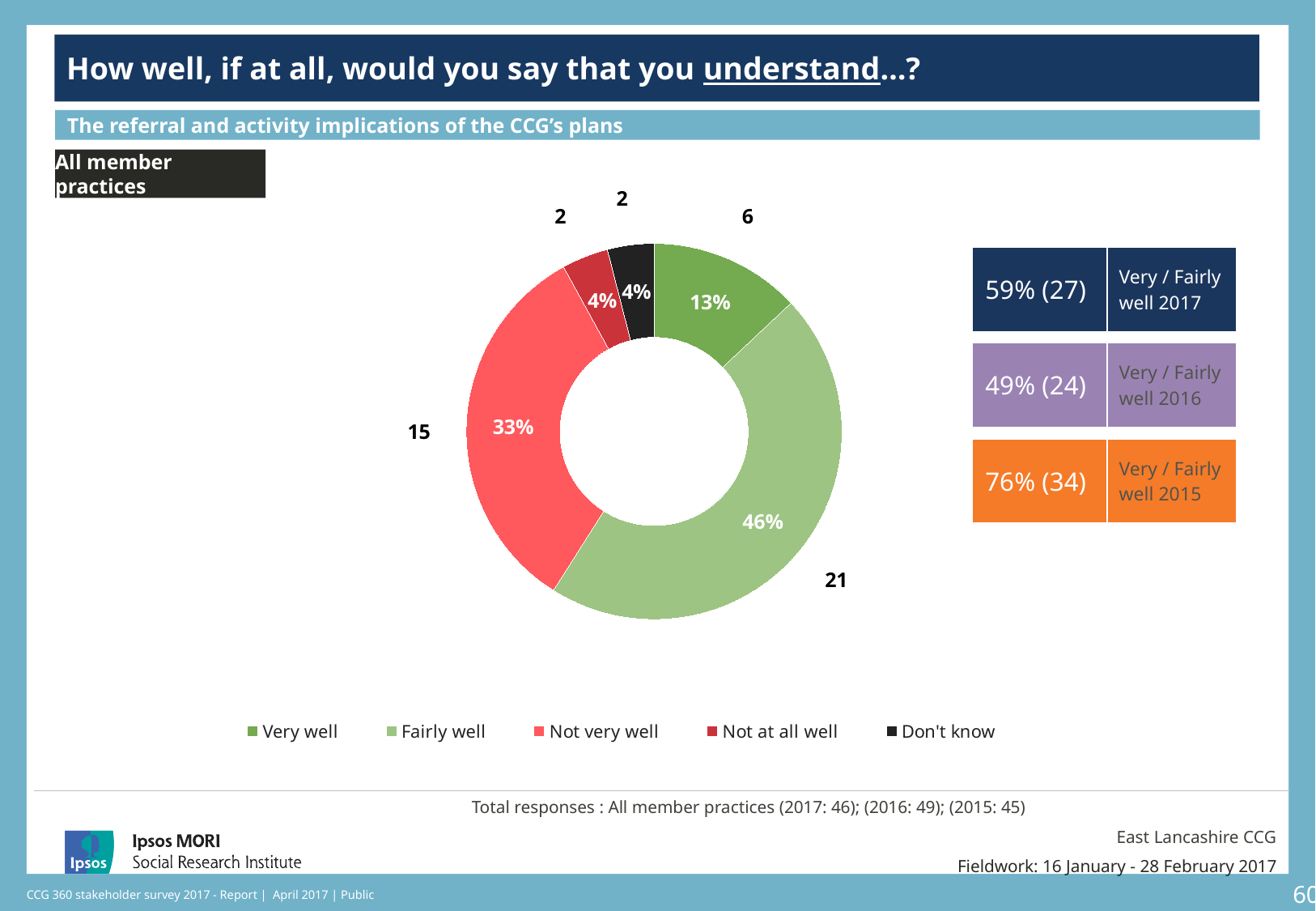
What percentage of respondents said they understand the referral and activity implications 'Fairly well'? 46% How many respondents answered 'Fairly well'? 21 What percentage of respondents answered 'Very well'? 13% What is the difference in percentage points between 'Fairly well' and 'Not very well'? 13 What kind of chart is shown on the slide? Donut (pie) chart How many respondents answered 'Not very well'? 15 Which response category has the largest share of the chart? Fairly well What colour represents 'Not at all well' in the chart? Dark red What percentage of respondents answered 'Not very well'? 33% Which is larger: the share for 'Very well' or the share for 'Not very well'? Not very well How many response categories does the legend list? 5 What percentage of respondents answered 'Don't know'? 4%